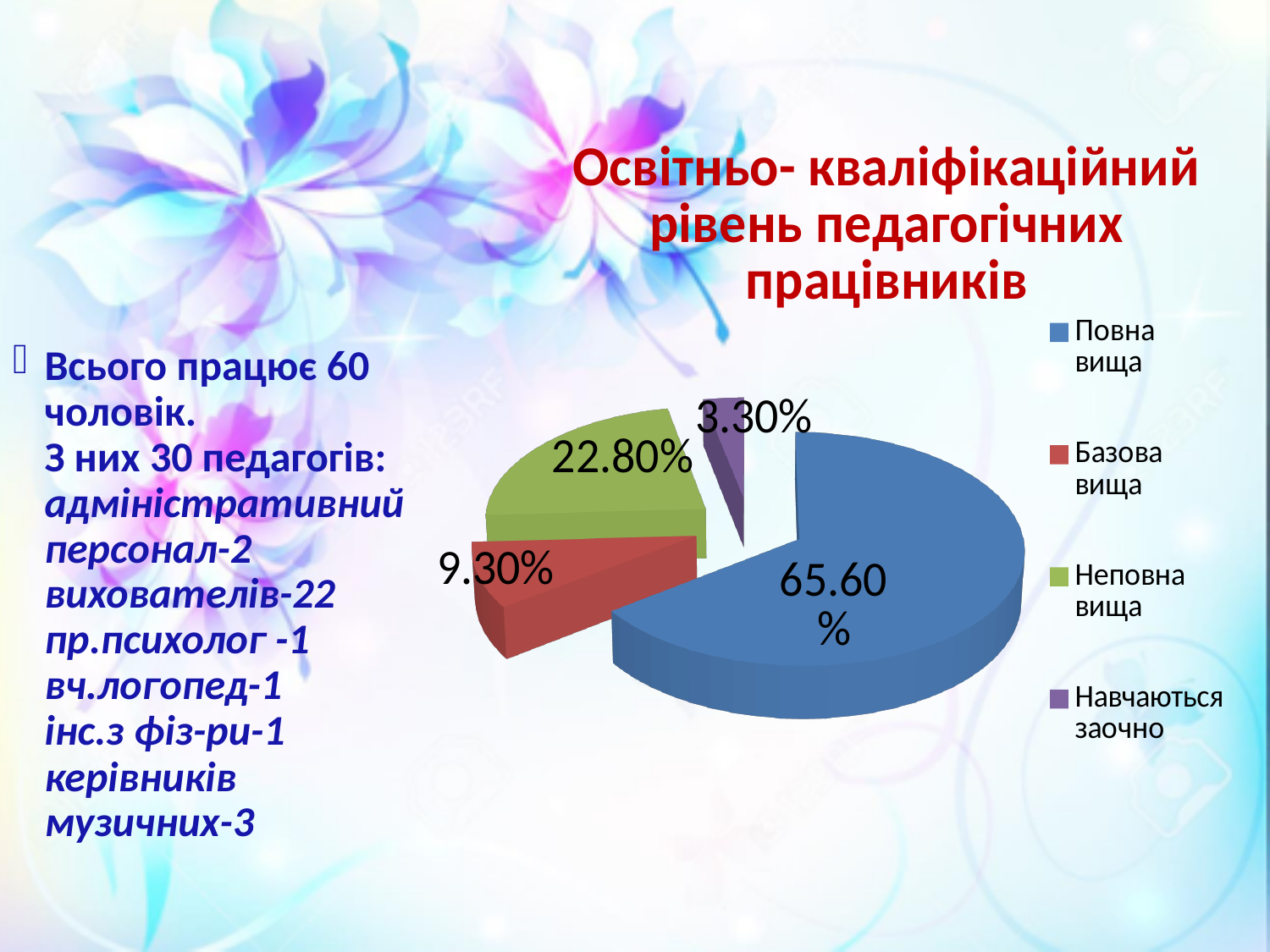
What is the title of the chart? Освітньо- кваліфікаційний рівень педагогічних працівників How many slices does the pie chart have? 4 Which category has the largest slice of the pie chart? Повна вища What value is printed on the "Базова вища" slice? 9.30% What percentage is shown for the "Неповна вища" slice? 22.80% What percentage of the pie chart is labelled for "Повна вища"? 65.60% What colour is the "Неповна вища" slice in the pie chart? Green What share of the pie is "Навчаються заочно"? 3.30% Which category has the smallest slice of the pie chart? Навчаються заочно Which is larger, the "Базова вища" slice or the "Неповна вища" slice? Неповна вища What is the difference in percentage points between "Повна вища" and "Неповна вища"? 42.80 What type of chart is shown on the slide? Pie chart